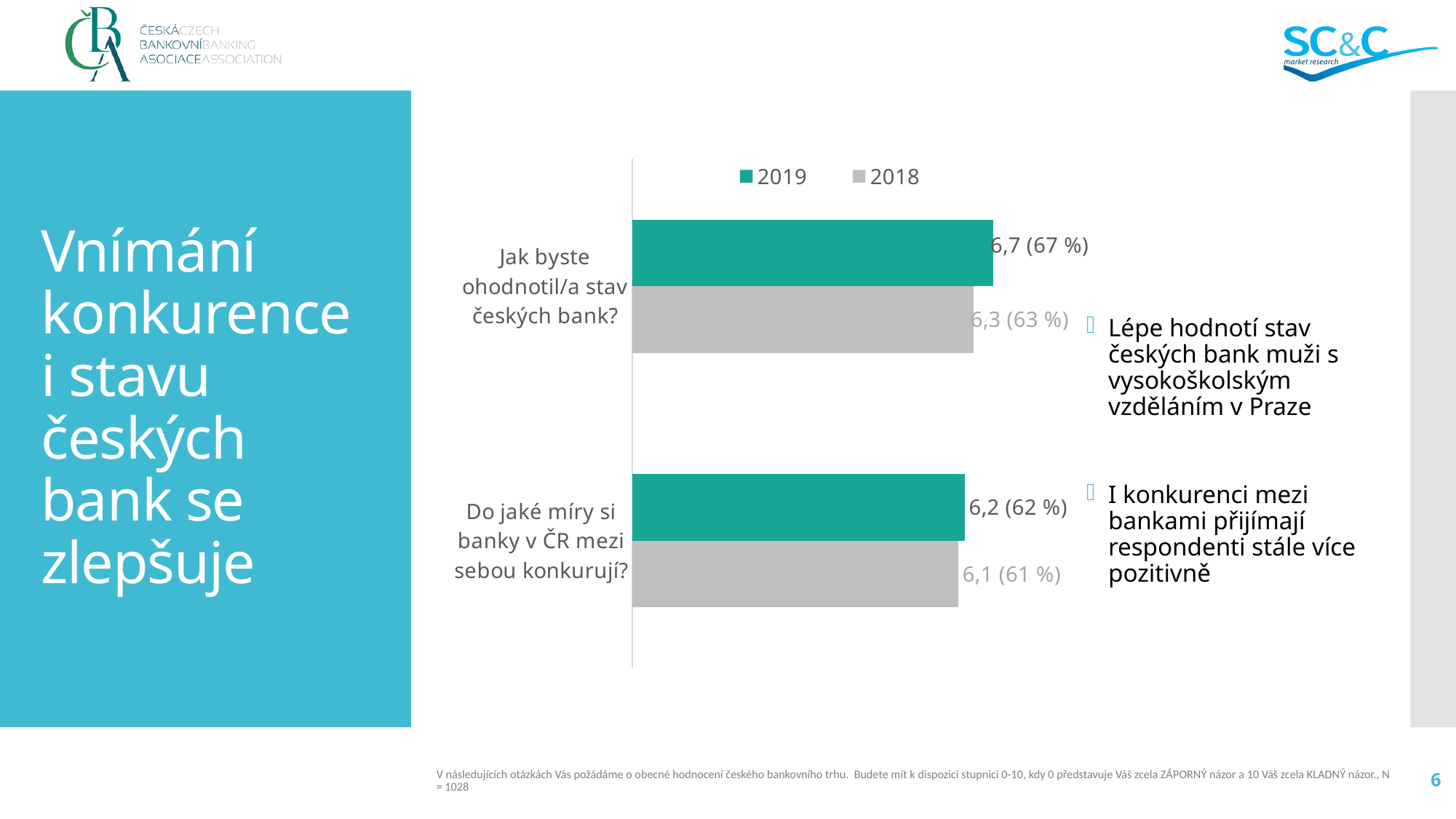
What kind of chart is shown on the slide? Bar chart What is the 2019 value for "Do jaké míry si banky v ČR mezi sebou konkurují?"? 6,2 (62 %) Which category has the highest 2019 value? Jak byste ohodnotil/a stav českých bank? What is the difference between the 2019 and 2018 values for "Jak byste ohodnotil/a stav českých bank?"? 0,4 How many series does the legend list? 2 What is the 2018 value for "Do jaké míry si banky v ČR mezi sebou konkurují?"? 6,1 (61 %) What is the 2018 value for "Jak byste ohodnotil/a stav českých bank?"? 6,3 (63 %) Which series has the higher value for "Jak byste ohodnotil/a stav českých bank?", 2019 or 2018? 2019 What is the difference between the 2019 and 2018 values for "Do jaké míry si banky v ČR mezi sebou konkurují?"? 0,1 What is the 2019 value for "Jak byste ohodnotil/a stav českých bank?"? 6,7 (67 %) How many categories are shown in the chart? 2 Which category has the lowest 2018 value? Do jaké míry si banky v ČR mezi sebou konkurují?